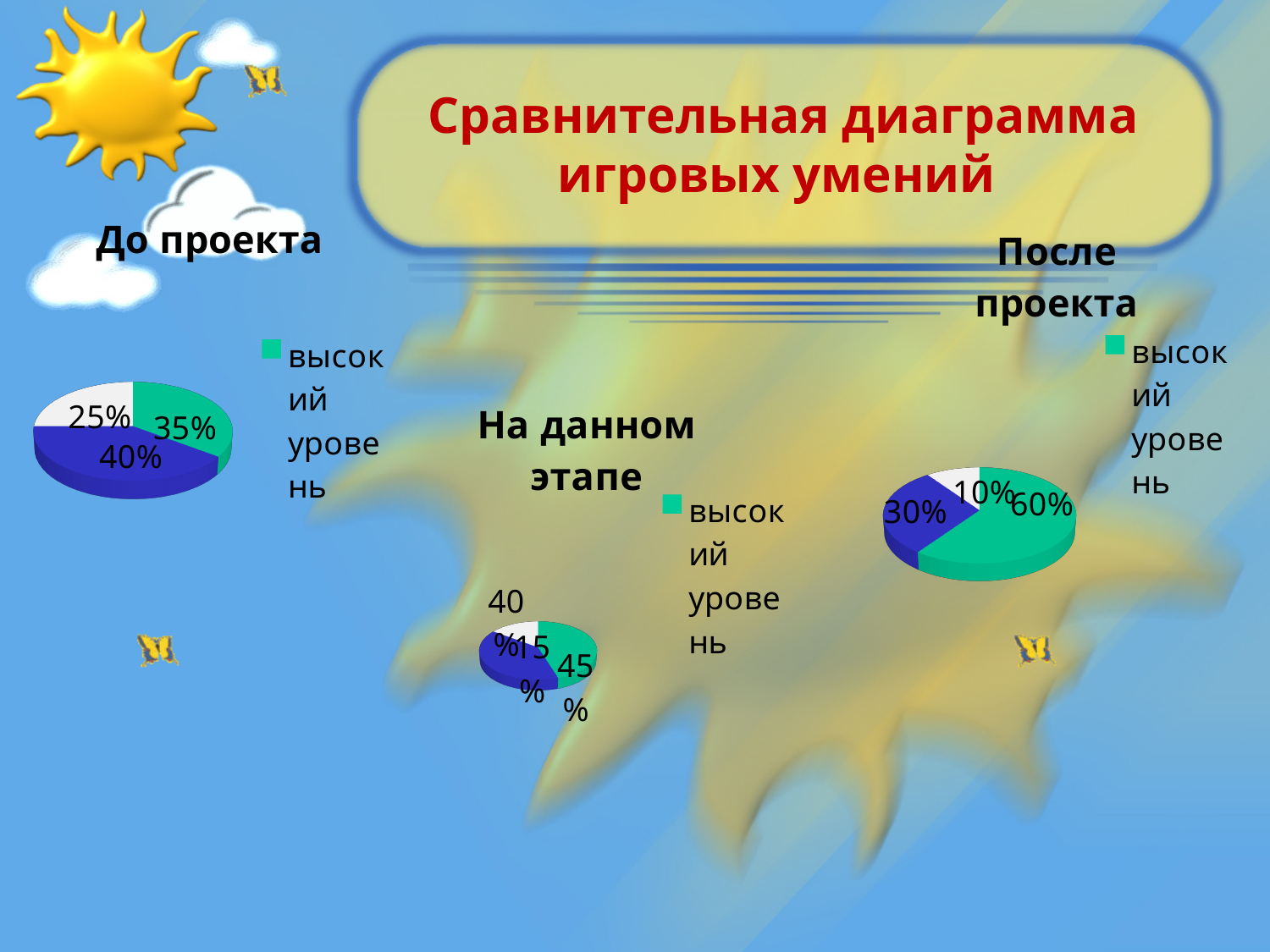
What is the title of the slide? Сравнительная диаграмма игровых умений How many pie charts are shown on the slide? 3 What is the difference between the 'высокий уровень' value in the 'После проекта' chart and in the 'До проекта' chart? 25% In the 'После проекта' pie chart, what is the smallest slice value? 10% What type of chart is used for 'До проекта'? Pie chart Which chart has the larger 'высокий уровень' slice, 'До проекта' or 'После проекта'? После проекта In the 'До проекта' pie chart, what is the value of the 'высокий уровень' slice? 35% In the 'После проекта' pie chart, what is the value of the 'высокий уровень' slice? 60% In the 'На данном этапе' pie chart, what is the smallest slice value? 15% In the 'До проекта' pie chart, what is the largest slice value? 40% How many slices does the 'После проекта' pie chart have? 3 In the 'На данном этапе' pie chart, what is the value of the 'высокий уровень' slice? 45%